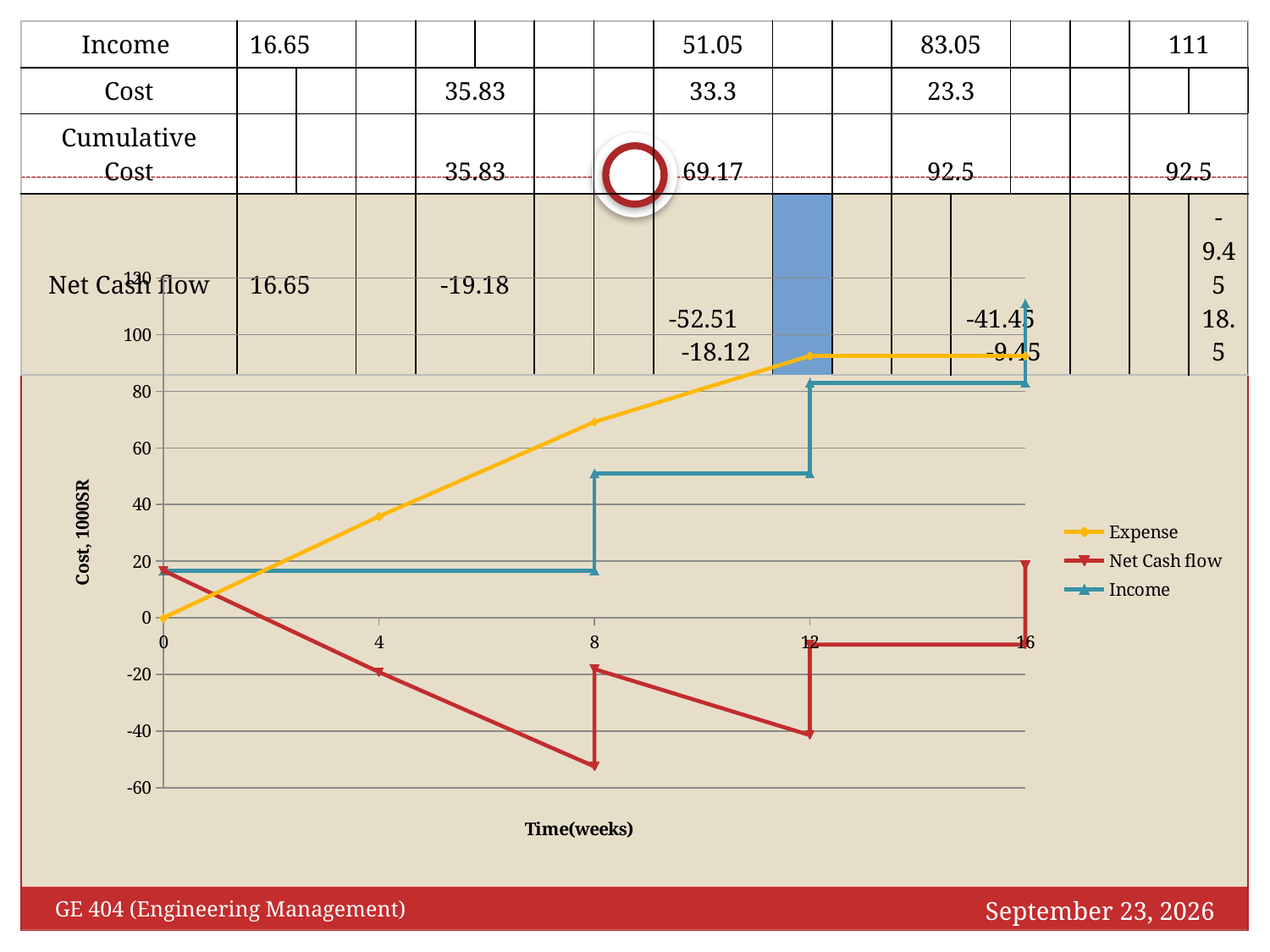
What is the title of the x axis of the chart? Time(weeks) At week 4, which is larger: Expense or Income? Expense What kind of chart is shown on the slide? line chart Does the Expense line rise or fall as time increases along the x axis? rise Is the Net Cash flow value at week 8 (its lowest point) greater or less than -40? less Which series reaches the lowest value on the chart? Net Cash flow How many series does the chart legend list? 3 Is the Expense value at week 12 greater or less than 80? greater What are the series names listed in the chart legend? Expense, Net Cash flow, Income What is the Expense value at week 0? 0